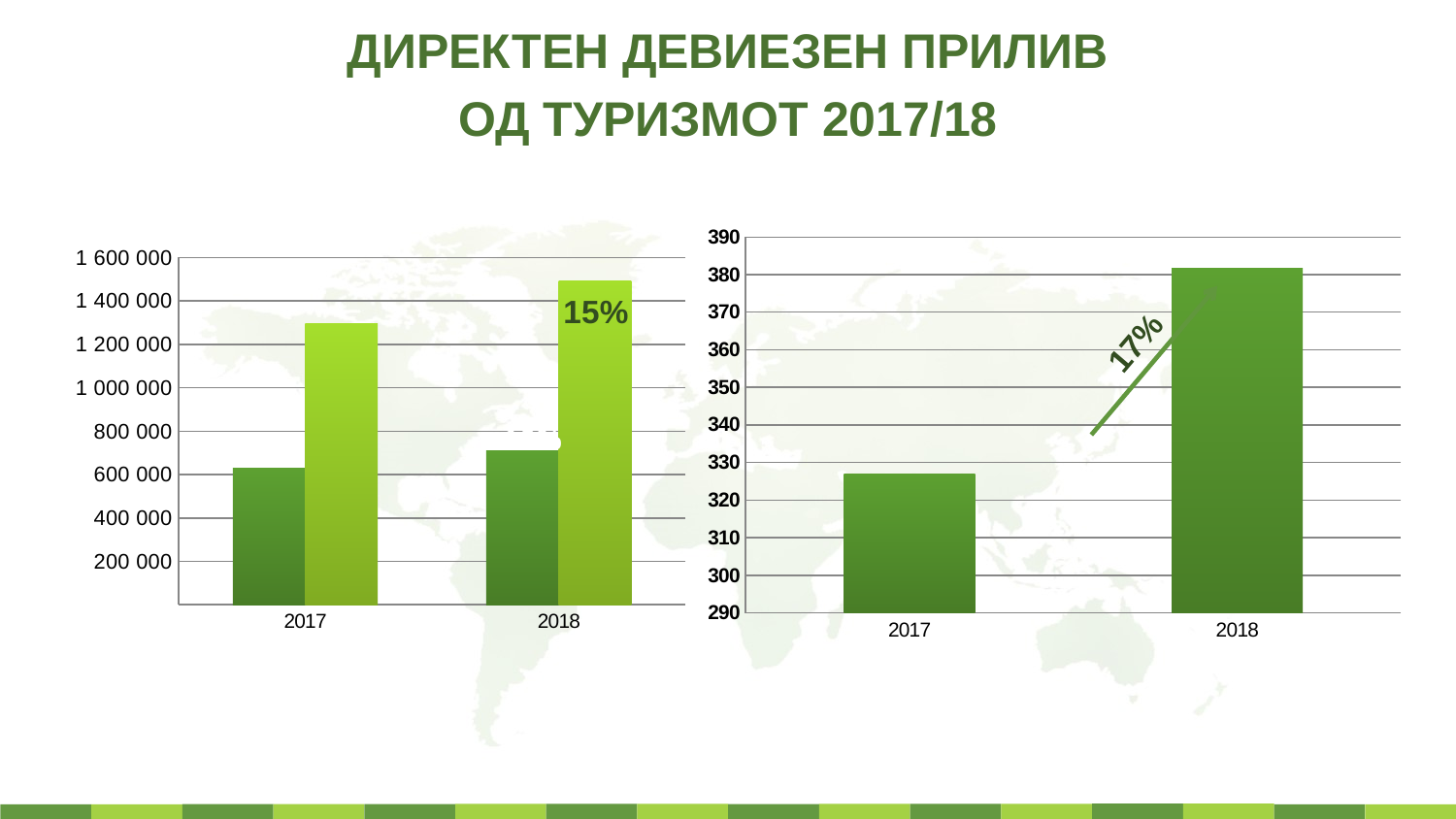
In the chart on the left, do the light green bars rise or fall from 2017 to 2018? rise In the chart on the left, is the light green bar for 2018 greater or less than 1 400 000? greater In the chart on the right, is the value for 2017 greater or less than 340? less In the chart on the right, how many categories are shown on the x axis? 2 What kind of chart is the chart on the right of the slide? bar chart In the chart on the left, is the dark green bar for 2017 greater or less than 800 000? less What percentage label is shown on the chart on the right? 17% In the chart on the left, how many bars are plotted in total? 4 What kind of chart is the chart on the left of the slide? bar chart In the chart on the right, which year has the higher value, 2017 or 2018? 2018 What percentage label is shown on the chart on the left? 15%